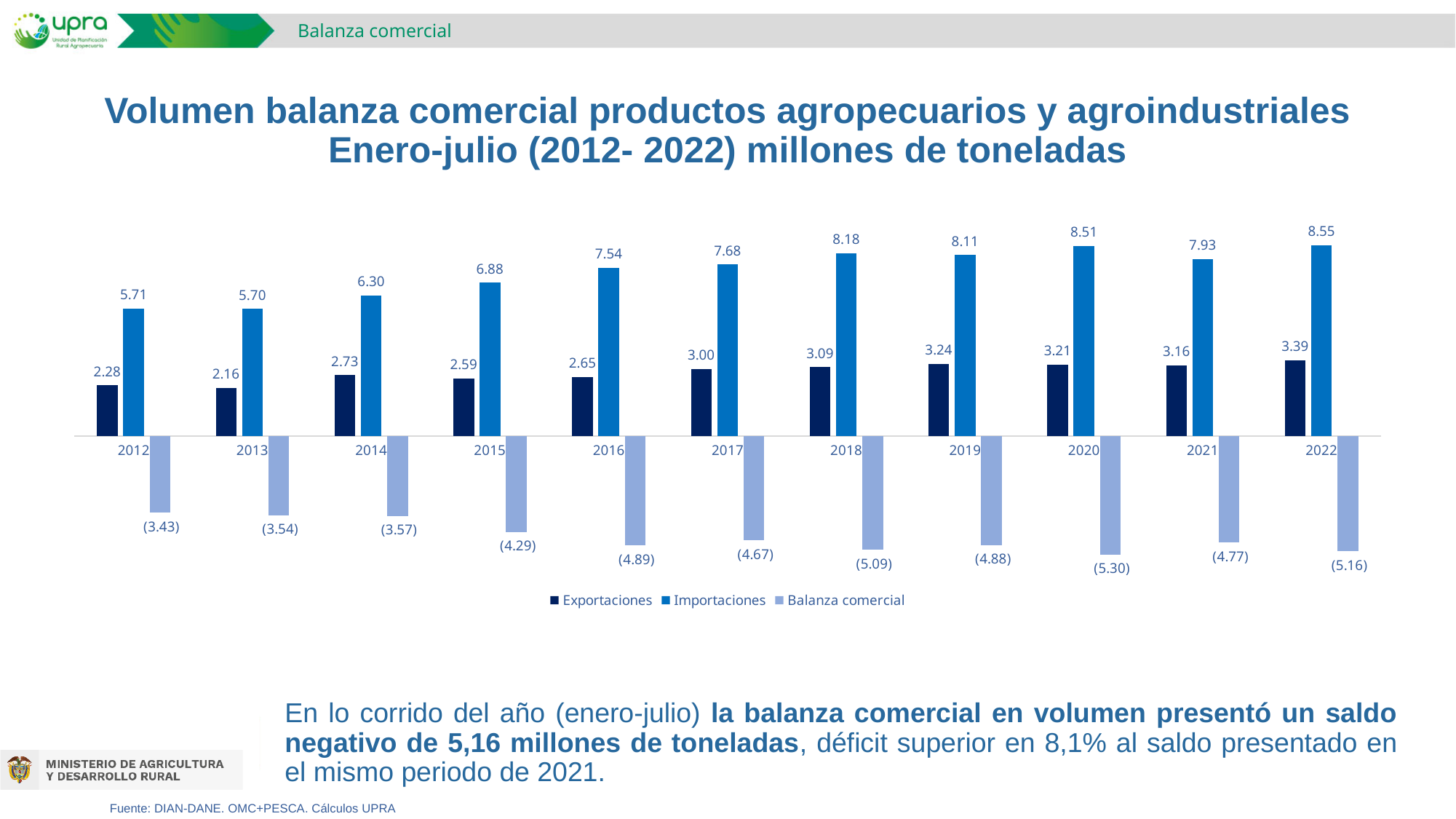
What is the value of Importaciones in 2022? 8.55 In which year is Exportaciones lowest? 2013 What is the difference between Importaciones and Exportaciones in 2022? 5.16 What is the value of Exportaciones in 2012? 2.28 Does Importaciones rise or fall from 2012 to 2022 overall? Rise How many series does the legend list? 3 Which series is shown in the lightest blue colour? Balanza comercial How many years are shown on the x axis? 11 What kind of chart is shown on the slide? Bar chart What is the value of Balanza comercial in 2020? (5.30) In which year is Importaciones highest? 2022 Which is larger, Exportaciones in 2019 or Exportaciones in 2020? Exportaciones in 2019